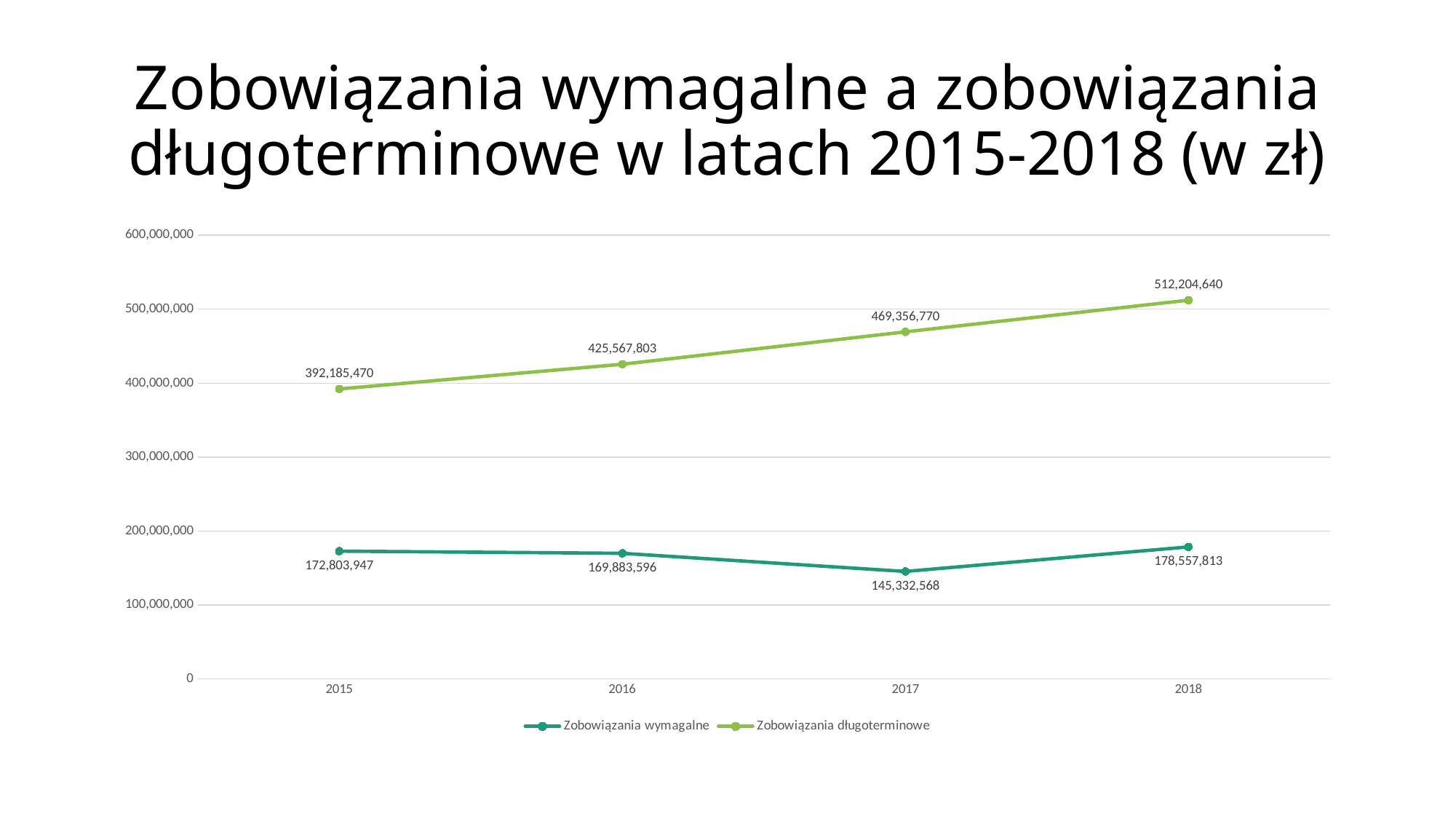
Is the value of Zobowiązania długoterminowe in 2017 greater or less than 400,000,000? greater By how much did Zobowiązania długoterminowe increase from 2015 to 2018? 120,019,170 How many series does the legend list? 2 What kind of chart is shown on the slide? line chart What is the value of Zobowiązania wymagalne in 2017? 145,332,568 In which year is Zobowiązania wymagalne highest? 2018 How many years are shown on the x axis? 4 In which year is Zobowiązania wymagalne lowest? 2017 What is the value of Zobowiązania długoterminowe in 2015? 392,185,470 Which is larger in 2016: Zobowiązania wymagalne or Zobowiązania długoterminowe? Zobowiązania długoterminowe What is the difference between Zobowiązania długoterminowe and Zobowiązania wymagalne in 2018? 333,646,827 What is the value of Zobowiązania długoterminowe in 2018? 512,204,640